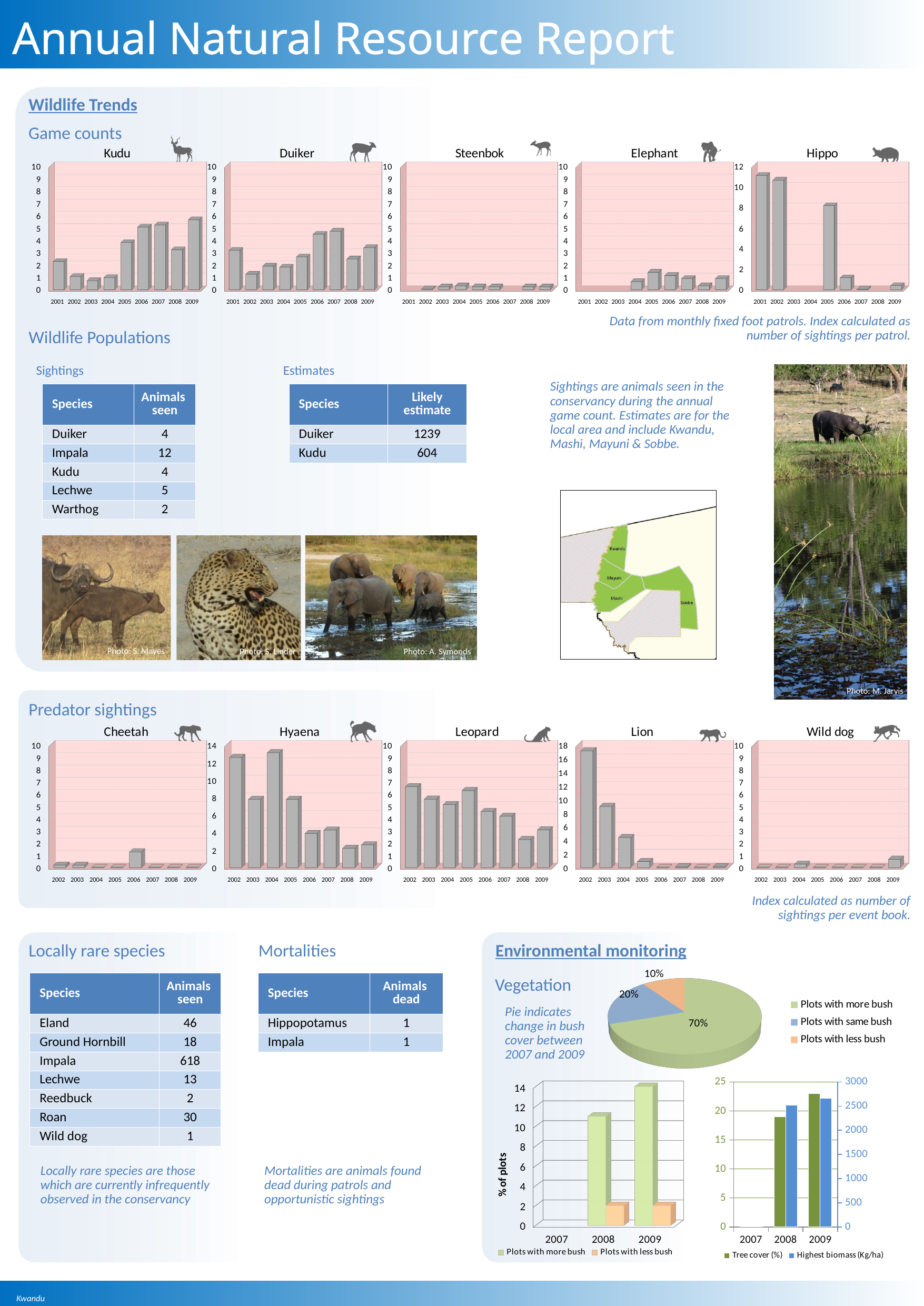
What kind of chart is the Vegetation chart showing 70%, 20% and 10%? Pie chart How many series does the legend list for the Tree cover and Highest biomass chart at the bottom right? 2 In the Vegetation pie chart, what share of plots had less bush? 10% In the Lion predator sightings chart, which year has the highest value? 2002 How many years are shown on the x axis of the Kudu game count chart? 9 In the Vegetation pie chart, which category has the largest slice? Plots with more bush In the Hippo game count chart, is the value for 2001 greater or less than 10? greater In the Lion predator sightings chart, do the values rise or fall from 2002 to 2005? fall In the Vegetation pie chart, what share of plots had more bush? 70% In the Hippo game count chart, which is larger, the value for 2005 or the value for 2006? 2005 How many slices does the Vegetation pie chart have? 3 In the Lion predator sightings chart, is the value for 2002 greater or less than 16? greater